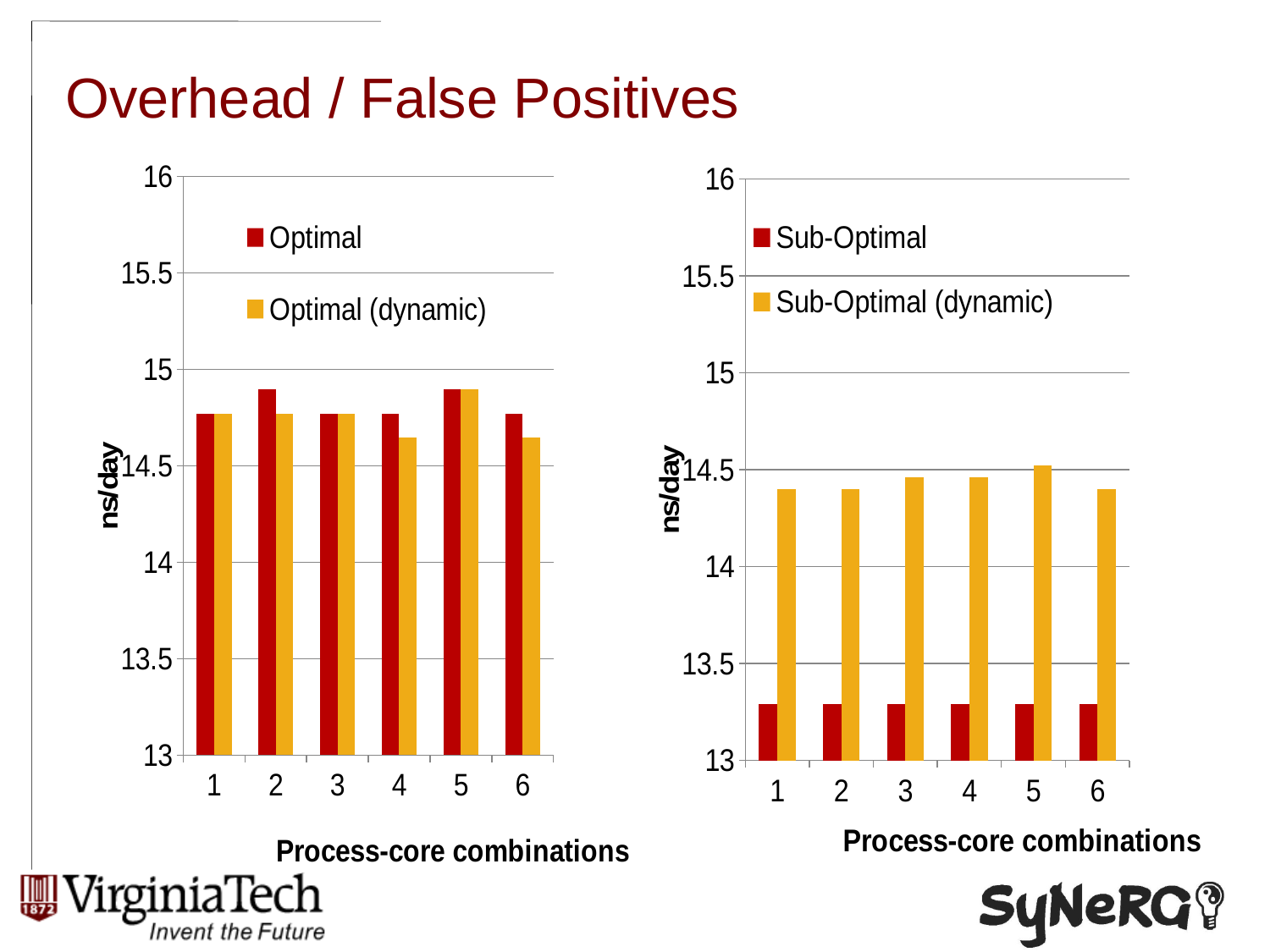
In the right chart, is the Sub-Optimal value for process-core combination 1 greater or less than 13.5? less In the left chart, which is larger for the Optimal series: process-core combination 1 or process-core combination 2? process-core combination 2 How many process-core combinations are shown on the x axis of the left chart? 6 In the left chart, which is larger for process-core combination 4: Optimal or Optimal (dynamic)? Optimal How many series does the legend of the right chart list? 2 What are the two legend entries of the left chart? Optimal and Optimal (dynamic) In the right chart, do the Sub-Optimal values rise, fall, or stay flat across the process-core combinations? stay flat In the right chart, which is larger for process-core combination 3: Sub-Optimal or Sub-Optimal (dynamic)? Sub-Optimal (dynamic) In the right chart, is the Sub-Optimal (dynamic) value for process-core combination 2 greater or less than 14? greater What is the y-axis label of the right chart? ns/day What kind of chart is the left chart (Optimal / Optimal (dynamic))? bar chart In the left chart, is the Optimal value for process-core combination 1 greater or less than 14.5? greater